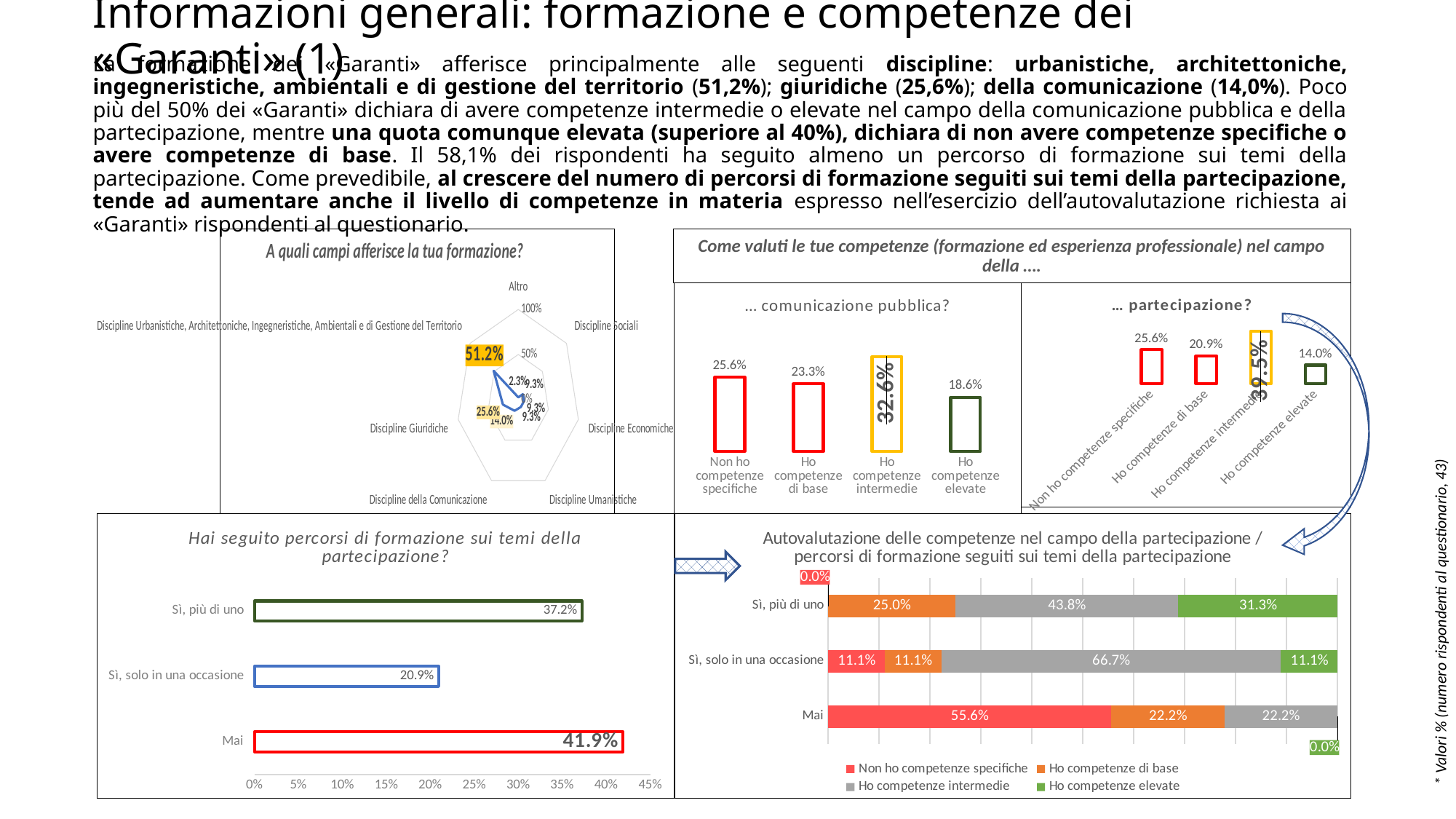
In the chart "Hai seguito percorsi di formazione sui temi della partecipazione?", what is the value for "Mai"? 41.9% What kind of chart is "A quali campi afferisce la tua formazione?"? Radar chart In the chart "Autovalutazione delle competenze nel campo della partecipazione / percorsi di formazione seguiti sui temi della partecipazione", how many series does the legend list? 4 In the chart "A quali campi afferisce la tua formazione?", what is the value for "Discipline Giuridiche"? 25.6% In the chart "... partecipazione?", what is the difference between "Non ho competenze specifiche" and "Ho competenze elevate"? 11.6% In the chart "... comunicazione pubblica?", what is the value for "Ho competenze intermedie"? 32.6% In the chart "... comunicazione pubblica?", which category has the lowest value? Ho competenze elevate In the chart "... partecipazione?", what is the value for "Ho competenze intermedie"? 39.5% In the chart "Hai seguito percorsi di formazione sui temi della partecipazione?", which category has the highest value? Mai In the chart "Autovalutazione delle competenze nel campo della partecipazione / percorsi di formazione seguiti sui temi della partecipazione", what is the value of "Ho competenze intermedie" for "Sì, solo in una occasione"? 66.7% In the chart "Autovalutazione delle competenze nel campo della partecipazione / percorsi di formazione seguiti sui temi della partecipazione", what is the value of "Non ho competenze specifiche" for "Mai"? 55.6% In the chart "Hai seguito percorsi di formazione sui temi della partecipazione?", how many categories are shown? 3